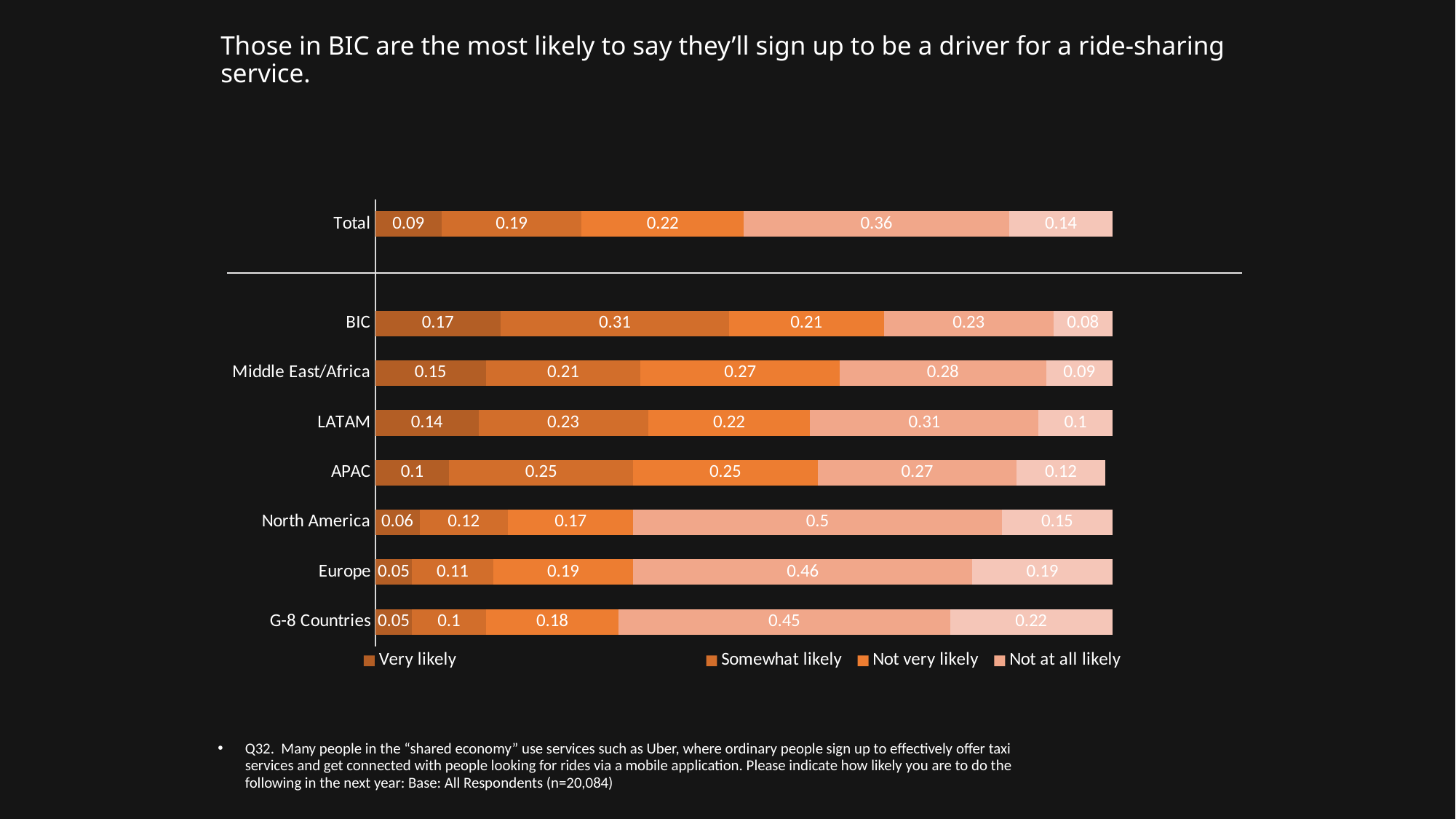
What is the difference between the 'Somewhat likely' value for BIC and for Total? 0.12 What is the 'Not at all likely' value for North America? 0.5 What is the 'Not very likely' value for APAC? 0.25 Which is larger, the 'Not very likely' value for Middle East/Africa or for LATAM? Middle East/Africa Which region has the highest 'Very likely' value? BIC What is the 'Very likely' value for BIC? 0.17 Which region has the highest 'Not at all likely' value? North America What kind of chart is shown on the slide? Stacked bar chart Which region has the lowest 'Somewhat likely' value? G-8 Countries How many bars are shown in the chart, including Total? 8 What is the combined 'Very likely' and 'Somewhat likely' value for BIC? 0.48 What is the 'Somewhat likely' value for Middle East/Africa? 0.21